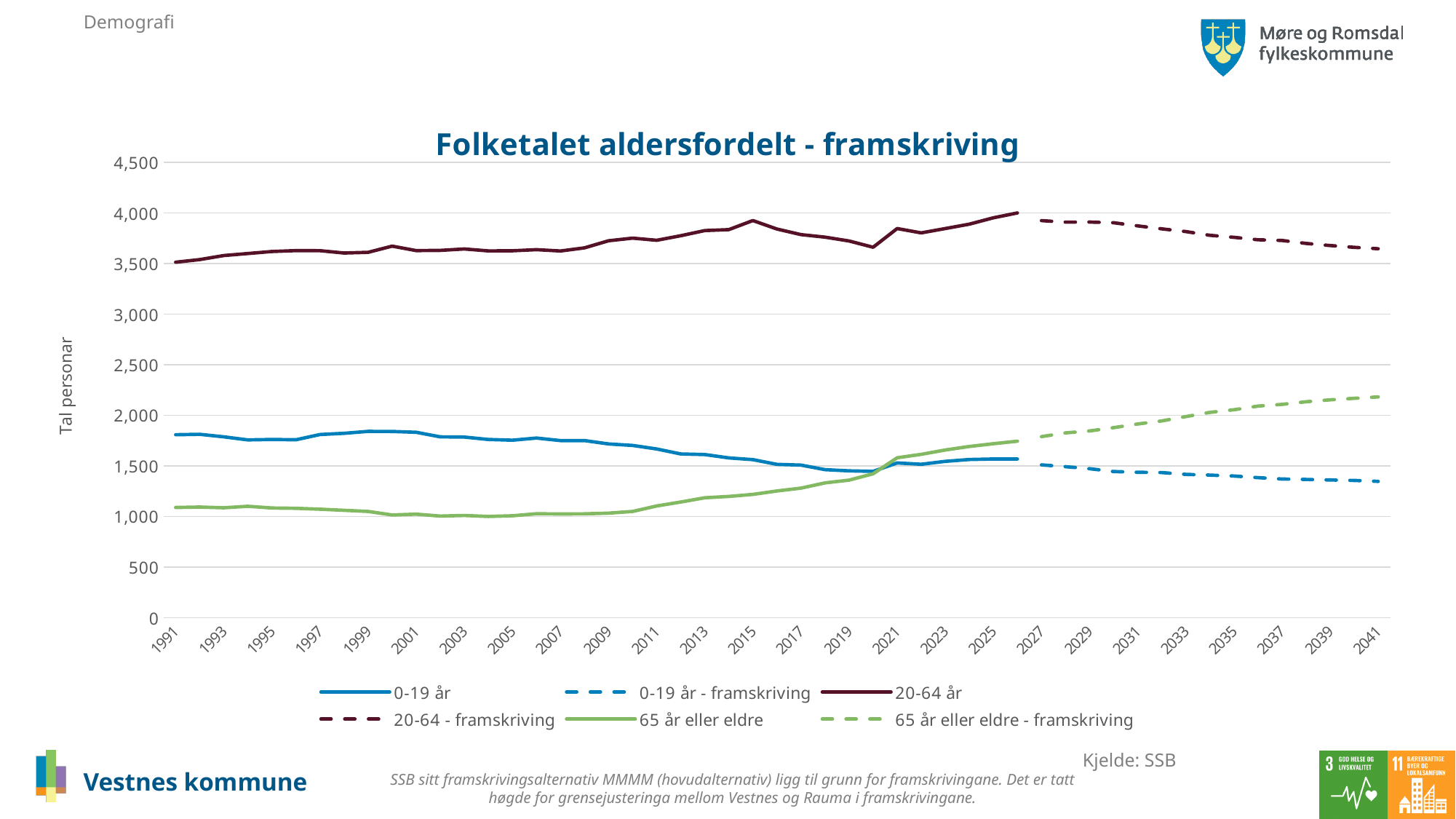
In 2041, which is larger: 65 år eller eldre - framskriving or 0-19 år - framskriving? 65 år eller eldre - framskriving In 1991, which is larger: 0-19 år or 65 år eller eldre? 0-19 år Does the 65 år eller eldre - framskriving line rise or fall from 2027 to 2041? rise What is the title of the chart? Folketalet aldersfordelt - framskriving What kind of chart is shown on the slide? line chart Is the value for 0-19 år - framskriving in 2041 greater or less than 1,500? less Which series has the highest values across the whole chart? 20-64 år What is the label on the vertical axis? Tal personar Is the value for 20-64 år in 2025 greater or less than 3,500? greater Is the value for 65 år eller eldre - framskriving in 2041 greater or less than 2,000? greater How many series does the legend list? 6